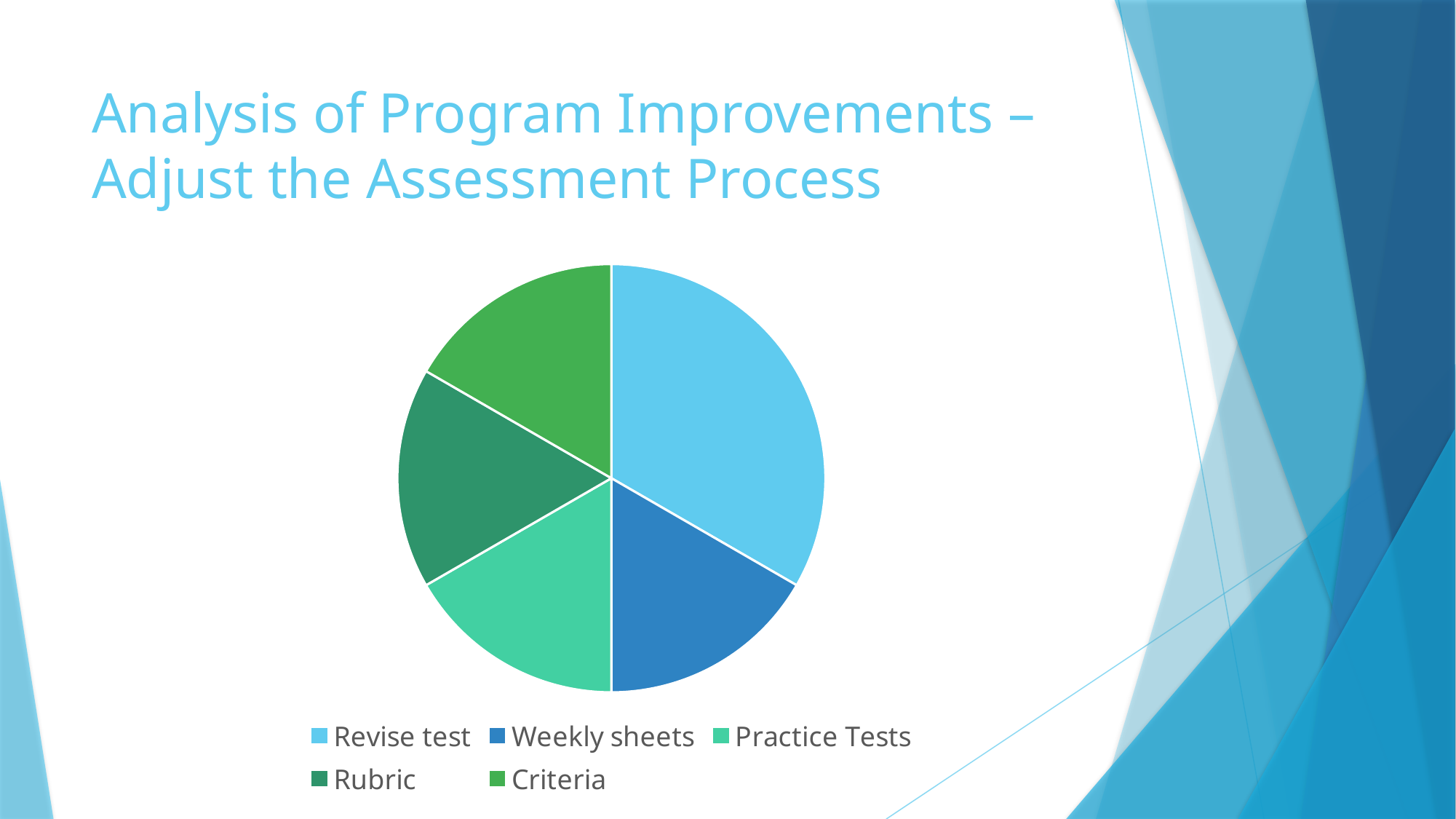
What is the title of the slide containing the pie chart? Analysis of Program Improvements – Adjust the Assessment Process Which slice is larger, Rubric or Revise test? Revise test How many categories does the pie chart show? 5 Which slice is larger, Revise test or Weekly sheets? Revise test How many entries does the legend of the pie chart list? 5 Which category is shown in light blue in the pie chart? Revise test Which slice is larger, Revise test or Criteria? Revise test What kind of chart is shown on the slide? pie chart Which category has the largest slice of the pie chart? Revise test